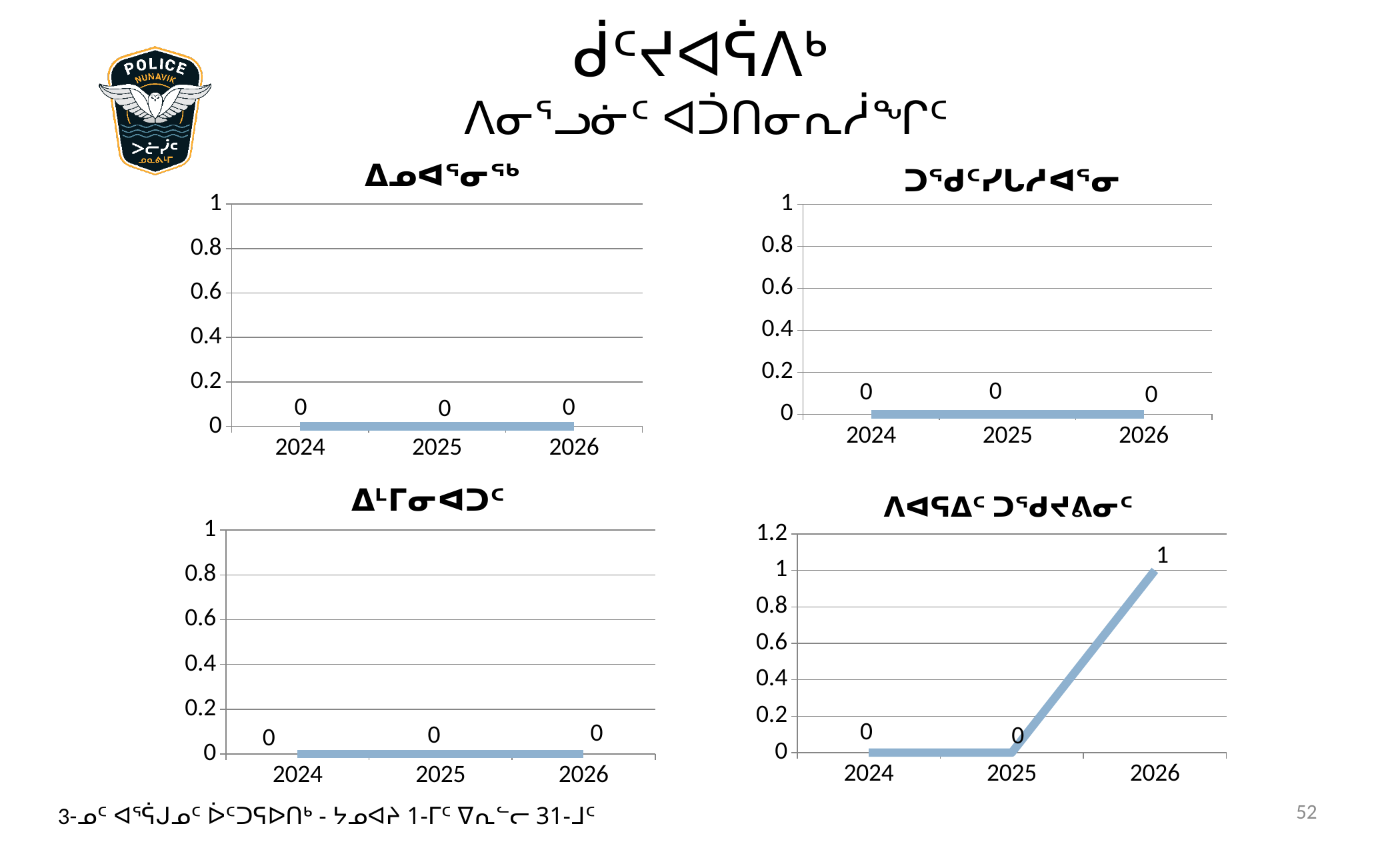
In the bottom-right chart, what is the difference between the values for 2026 and 2024? 1 What type of chart is the bottom-right chart on the slide? line chart In the top-left chart, what is the value for 2024? 0 In the bottom-right chart, which is larger, the value for 2026 or the value for 2025? 2026 In the bottom-left chart, what is the value for 2025? 0 In the bottom-right chart, which year has the highest value? 2026 How many years are plotted on the x axis of the top-left chart? 3 In the bottom-right chart, what is the value for 2026? 1 In the bottom-right chart, what is the value for 2025? 0 How many charts are shown on the slide? 4 In the bottom-right chart, do the values rise or fall from 2025 to 2026? rise In the top-right chart, what is the value for 2026? 0